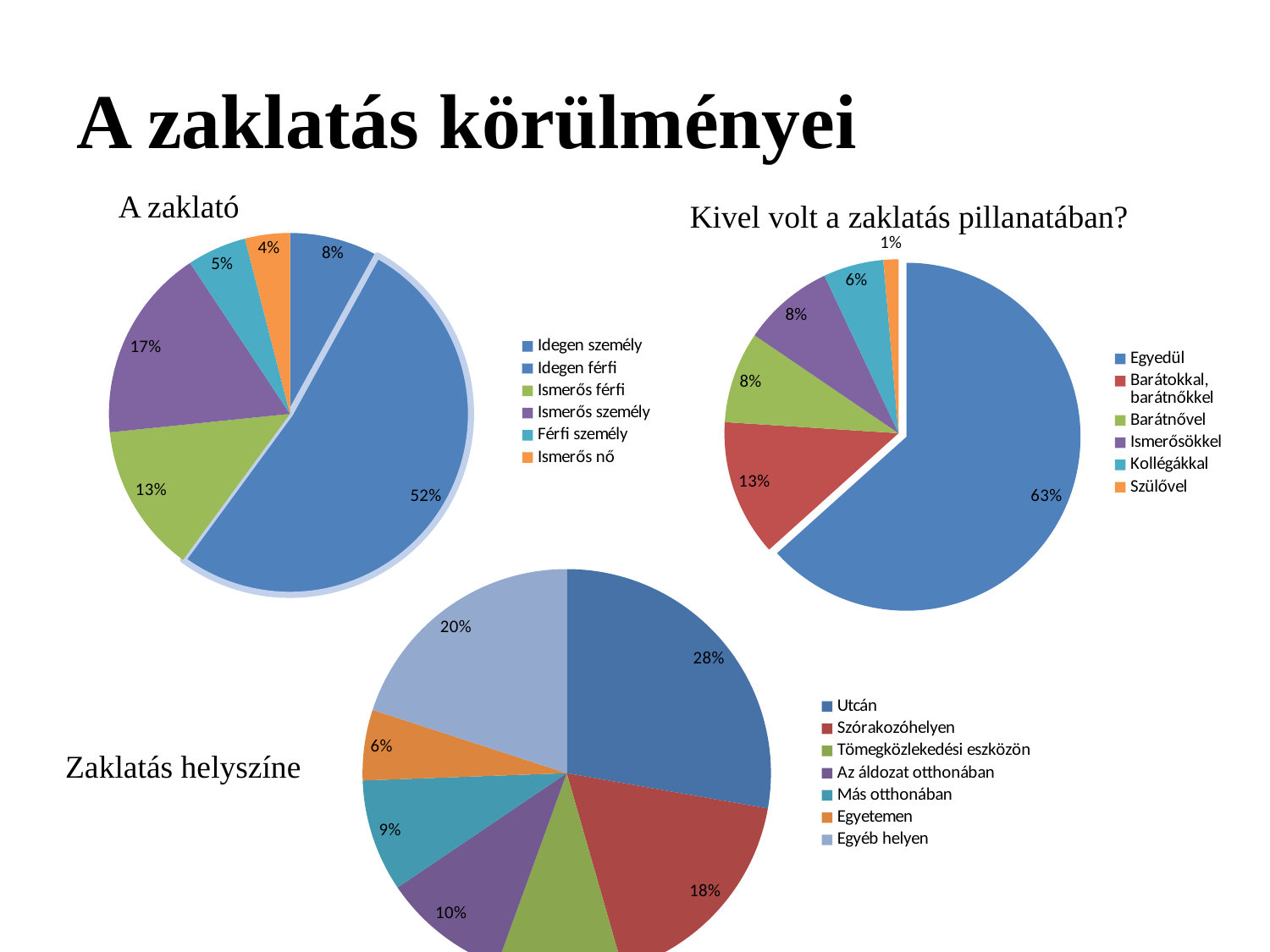
In the 'A zaklató' chart, how many categories does the legend list? 6 In the 'A zaklató' chart, what percentage is shown for Idegen férfi? 52% In the 'Zaklatás helyszíne' chart, how many categories does the legend list? 7 In the 'Kivel volt a zaklatás pillanatában?' chart, what percentage is shown for Szülővel? 1% In the 'Zaklatás helyszíne' chart, what percentage is shown for Utcán? 28% In the 'Kivel volt a zaklatás pillanatában?' chart, what percentage is shown for Egyedül? 63% What type of chart is used for 'Zaklatás helyszíne'? Pie chart In the 'Kivel volt a zaklatás pillanatában?' chart, which is larger, Kollégákkal or Ismerősökkel? Ismerősökkel In the 'A zaklató' chart, what percentage is shown for Ismerős személy? 17% In the 'A zaklató' chart, which category has the smallest slice? Ismerős nő In the 'Zaklatás helyszíne' chart, what percentage is shown for Egyéb helyen? 20% In the 'Kivel volt a zaklatás pillanatában?' chart, what is the difference between the Egyedül and Barátokkal, barátnőkkel slices? 50%